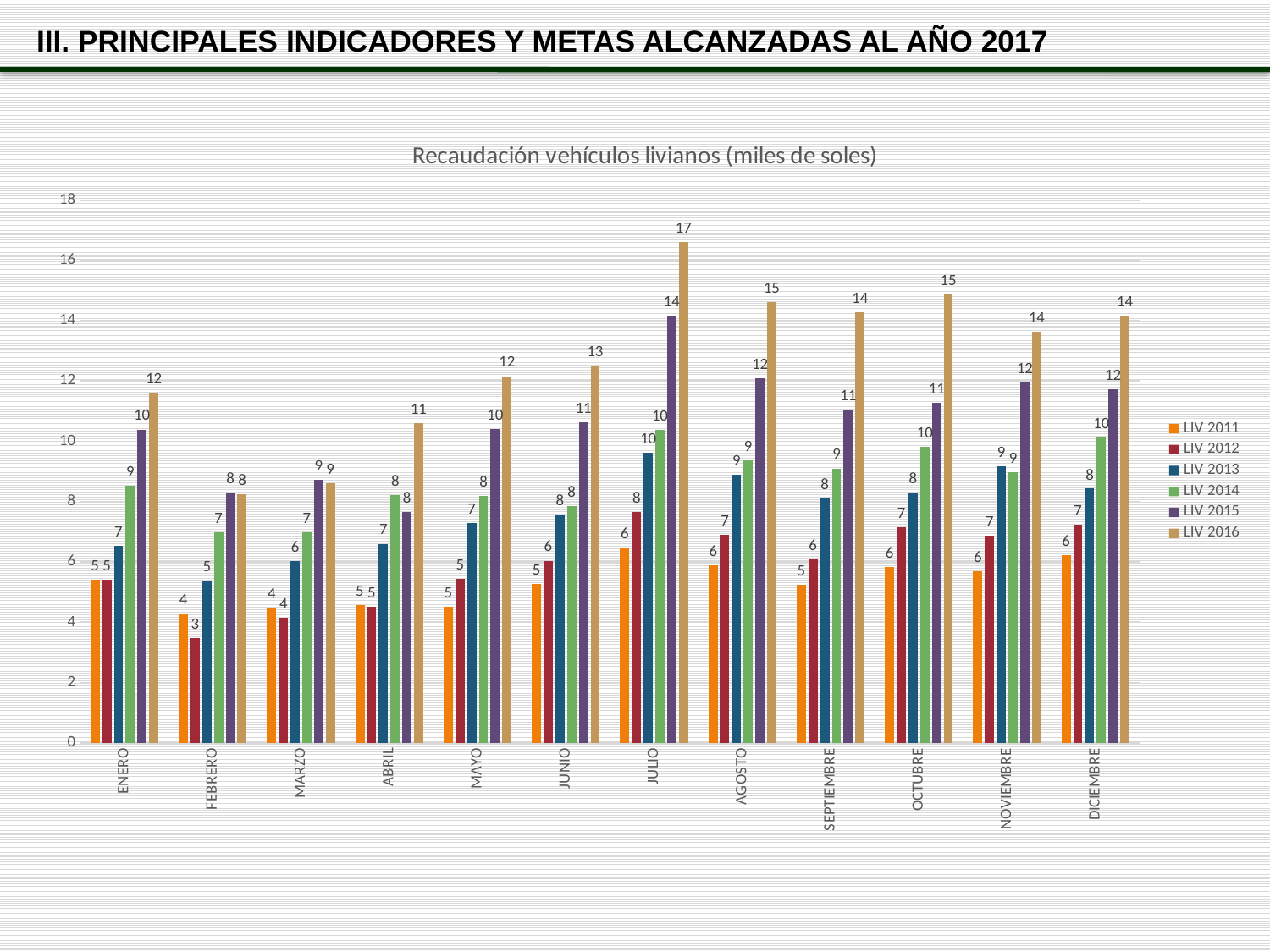
In which month is the LIV 2016 value highest? JULIO In which month is the LIV 2012 value lowest? FEBRERO Do the LIV 2013 values rise or fall from FEBRERO to JULIO? rise Is the value for LIV 2016 in JULIO greater or less than 16? greater What is the difference between the LIV 2016 and LIV 2011 values in JULIO? 11 Which is larger, the LIV 2016 value in ENERO or in FEBRERO? ENERO How many series does the legend list? 6 How many months are shown on the x axis? 12 What is the value for LIV 2012 in FEBRERO? 3 What is the value for LIV 2015 in NOVIEMBRE? 12 What is the value for LIV 2016 in JULIO? 17 What kind of chart is shown on the slide? bar chart